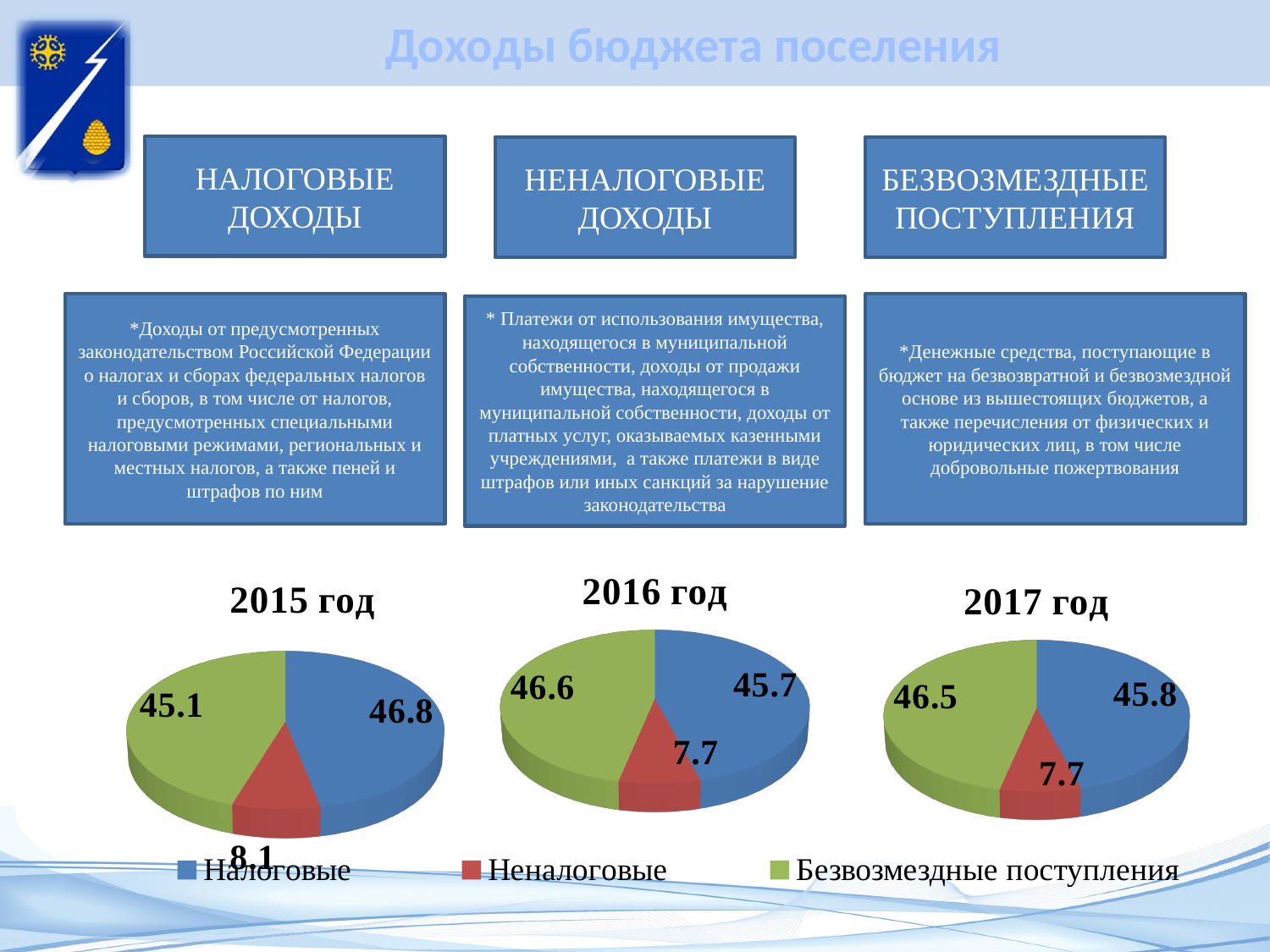
What kind of chart is the 2016 год chart? Pie chart In the 2015 год chart, which category has the largest slice? Налоговые In the 2016 год chart, what is the value for Безвозмездные поступления? 46.6 In the 2017 год chart, which category has the largest slice? Безвозмездные поступления In the 2016 год chart, which category has the smallest slice? Неналоговые In the 2015 год chart, what is the value for Неналоговые? 8.1 How many entries does the shared legend list? 3 In the 2017 год chart, what is the value for Неналоговые? 7.7 How many slices does the 2017 год chart have? 3 In the 2015 год chart, what is the difference between the values for Налоговые and Безвозмездные поступления? 1.7 In the 2016 год chart, which is larger: Налоговые or Безвозмездные поступления? Безвозмездные поступления In the 2015 год chart, what is the value for Налоговые? 46.8